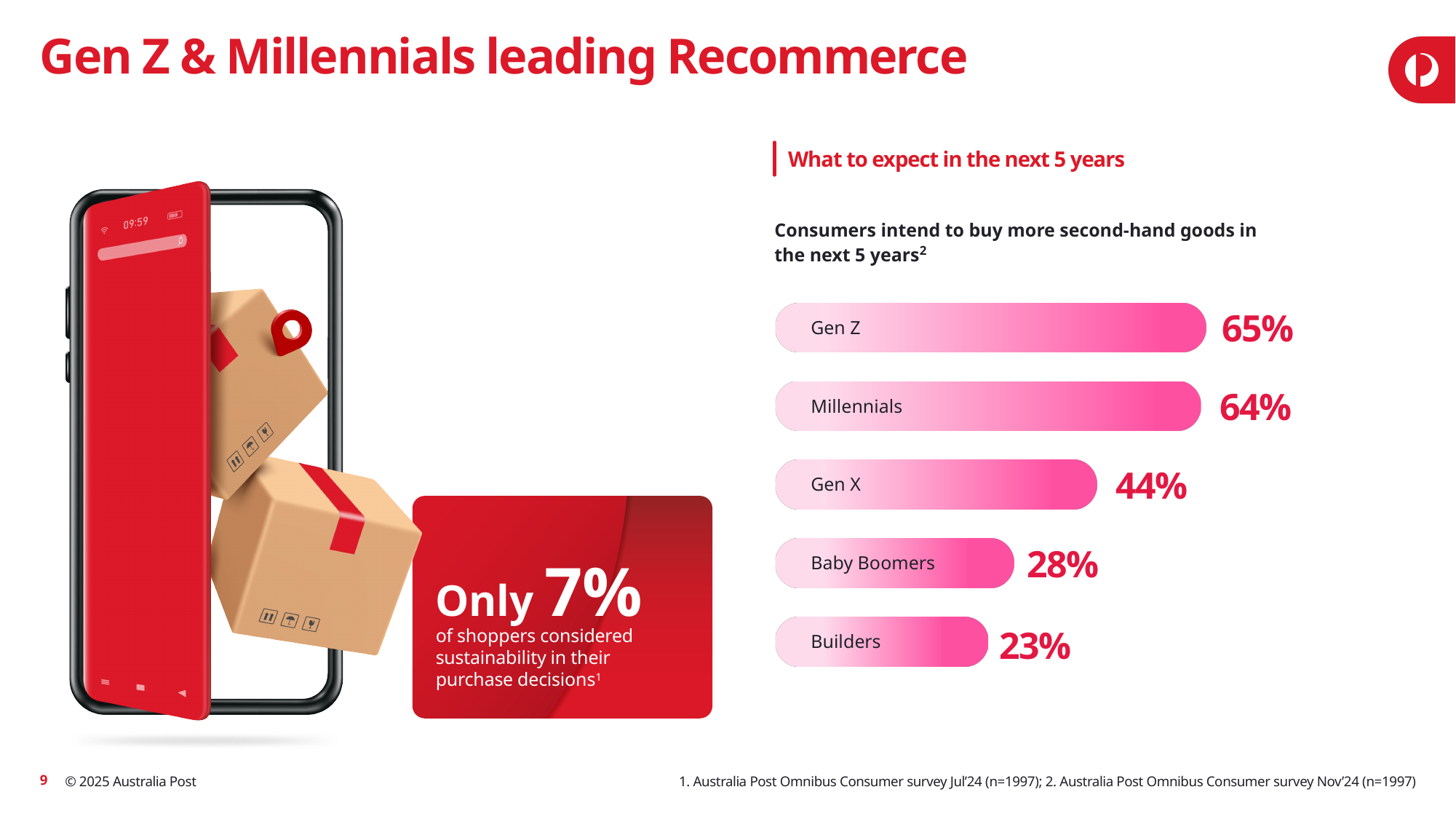
Which generation has the lowest share intending to buy more second-hand goods? Builders What is the value shown for Gen X in the chart? 44% What is the difference in percentage points between Baby Boomers and Builders? 5 Which generation has the highest share intending to buy more second-hand goods? Gen Z Which is larger, the value for Gen X or the value for Baby Boomers? Gen X What is the value shown for Baby Boomers in the chart? 28% What kind of chart is used to show consumers' intent to buy second-hand goods? Bar chart What percentage of Gen Z consumers intend to buy more second-hand goods in the next 5 years? 65% What is the difference in percentage points between Gen Z and Gen X? 21 How many generation categories are shown in the chart? 5 What is the value shown for Builders in the chart? 23% What is the value shown for Millennials in the chart? 64%